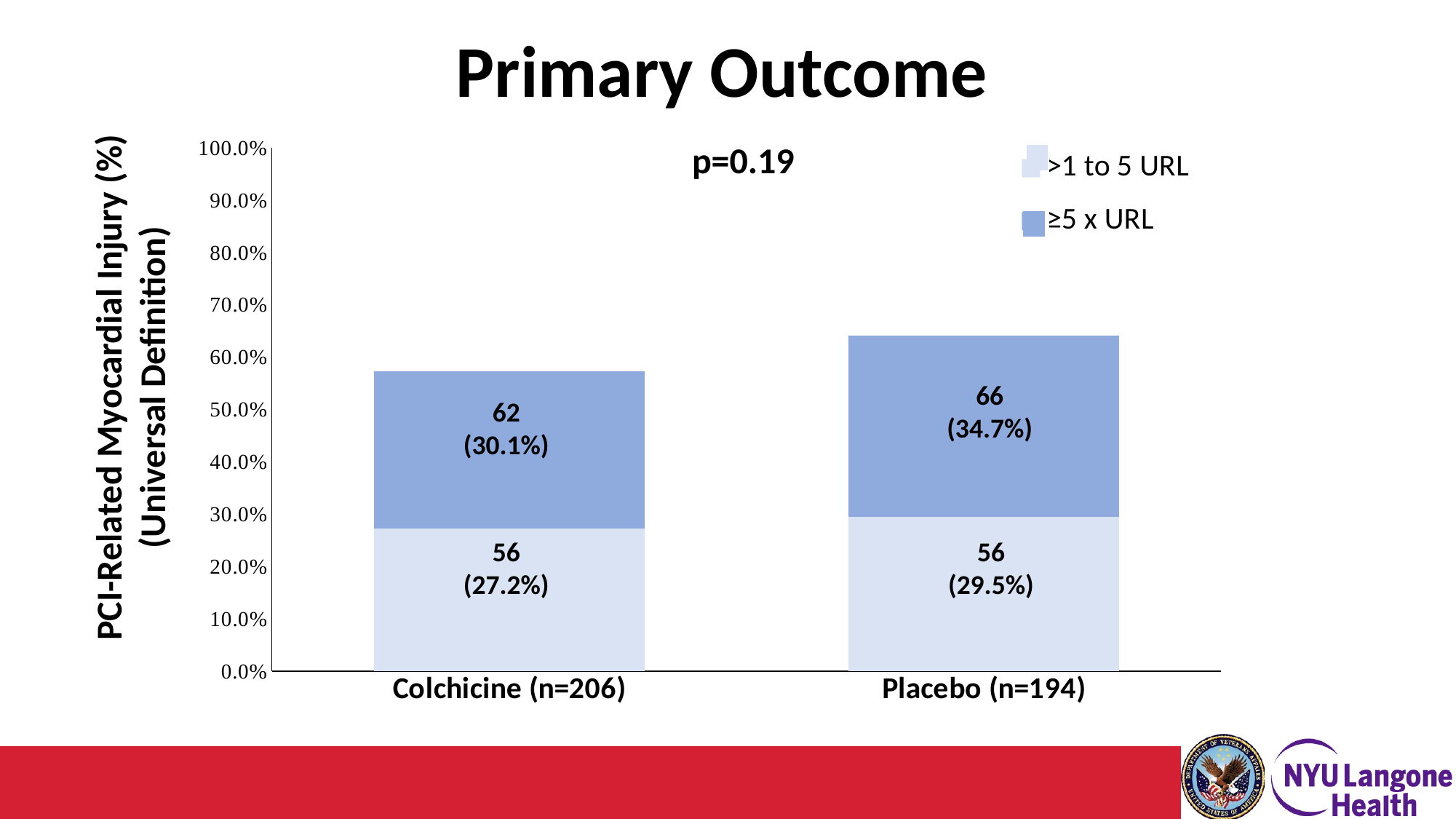
How many patients are in the >1 to 5 URL segment of the Colchicine (n=206) bar? 56 What kind of chart is shown on the slide? Stacked bar chart What is the percentage for the >1 to 5 URL segment in the Placebo (n=194) bar? 29.5% What is the total percentage of the stacked bar for Colchicine (n=206)? 57.3% What p-value is printed on the chart? p=0.19 How many categories are shown on the x axis? 2 What is the difference in the ≥5 x URL percentage between Placebo (n=194) and Colchicine (n=206)? 4.6% Which group has the higher percentage for ≥5 x URL, Colchicine (n=206) or Placebo (n=194)? Placebo (n=194) What is the percentage for the ≥5 x URL segment in the Colchicine (n=206) bar? 30.1% How many series does the legend list? 2 What is the total percentage of the stacked bar for Placebo (n=194)? 64.2% How many patients are in the ≥5 x URL segment of the Placebo (n=194) bar? 66